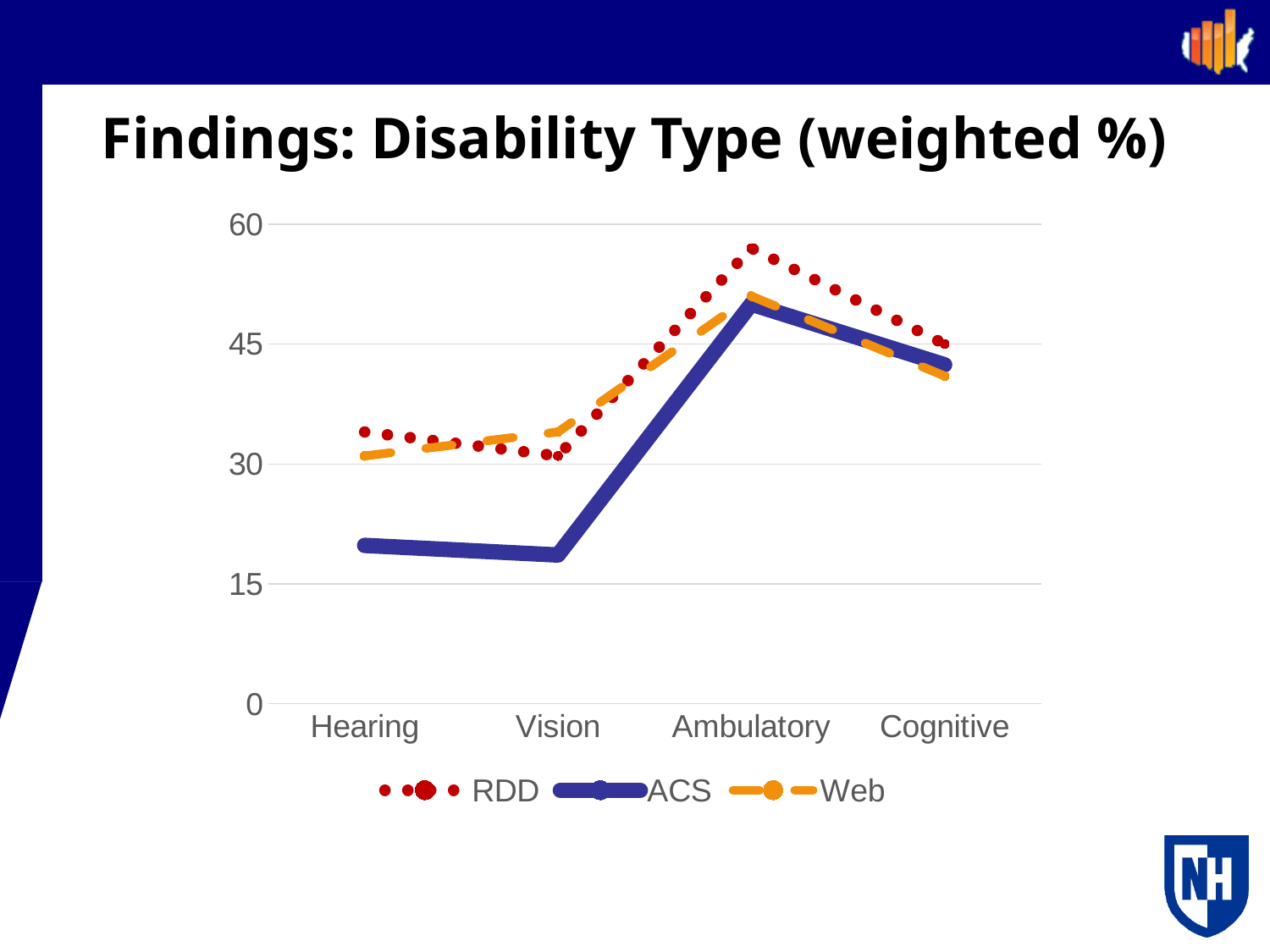
Is the ACS value for Hearing greater or less than 30? less For which disability type is the ACS series lowest? Vision For which disability type is the RDD series highest? Ambulatory Is the Web value for Cognitive greater or less than 45? less What kind of chart is shown on the slide? line chart What is the title of the chart? Findings: Disability Type (weighted %) Which series is drawn as a solid blue line? ACS Is the RDD value for Ambulatory greater or less than 45? greater How many disability type categories are shown on the x axis? 4 At Hearing, which series has the larger value, RDD or ACS? RDD How many series does the legend list? 3